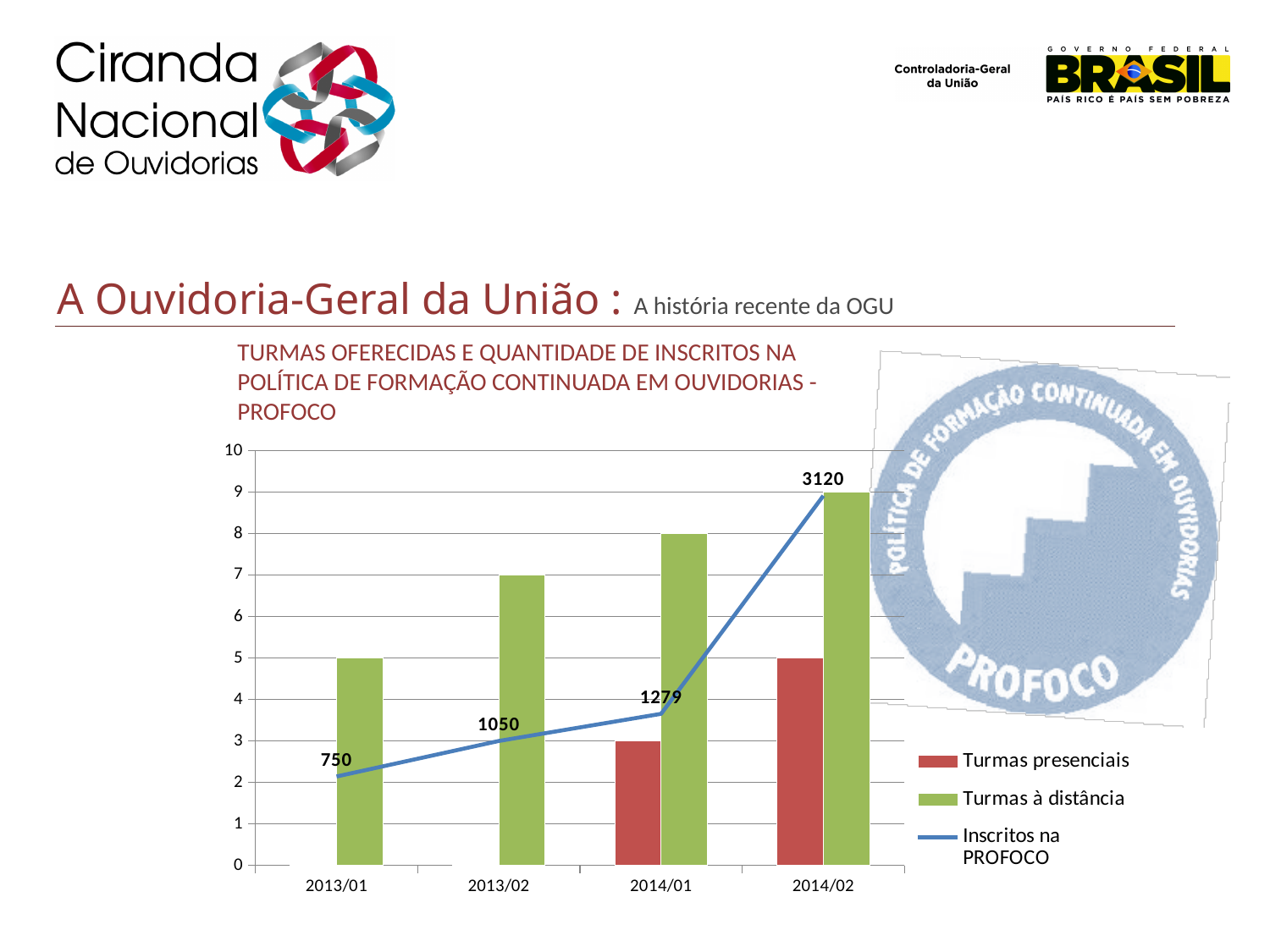
How many periods are shown on the x axis? 4 How many Turmas à distância were offered in 2013/02? 7 What is the difference in Inscritos na PROFOCO between 2014/02 and 2014/01? 1841 What is the value of Inscritos na PROFOCO for 2013/01? 750 Which series is shown as a line rather than bars? Inscritos na PROFOCO Which is larger in 2014/01: Turmas presenciais or Turmas à distância? Turmas à distância How many Turmas presenciais were offered in 2014/02? 5 How many series does the legend list? 3 In which period is the Turmas à distância bar lowest? 2013/01 What is the value of Inscritos na PROFOCO for 2014/02? 3120 Does Inscritos na PROFOCO rise or fall from 2013/01 to 2014/02? rise In which period is Inscritos na PROFOCO highest? 2014/02